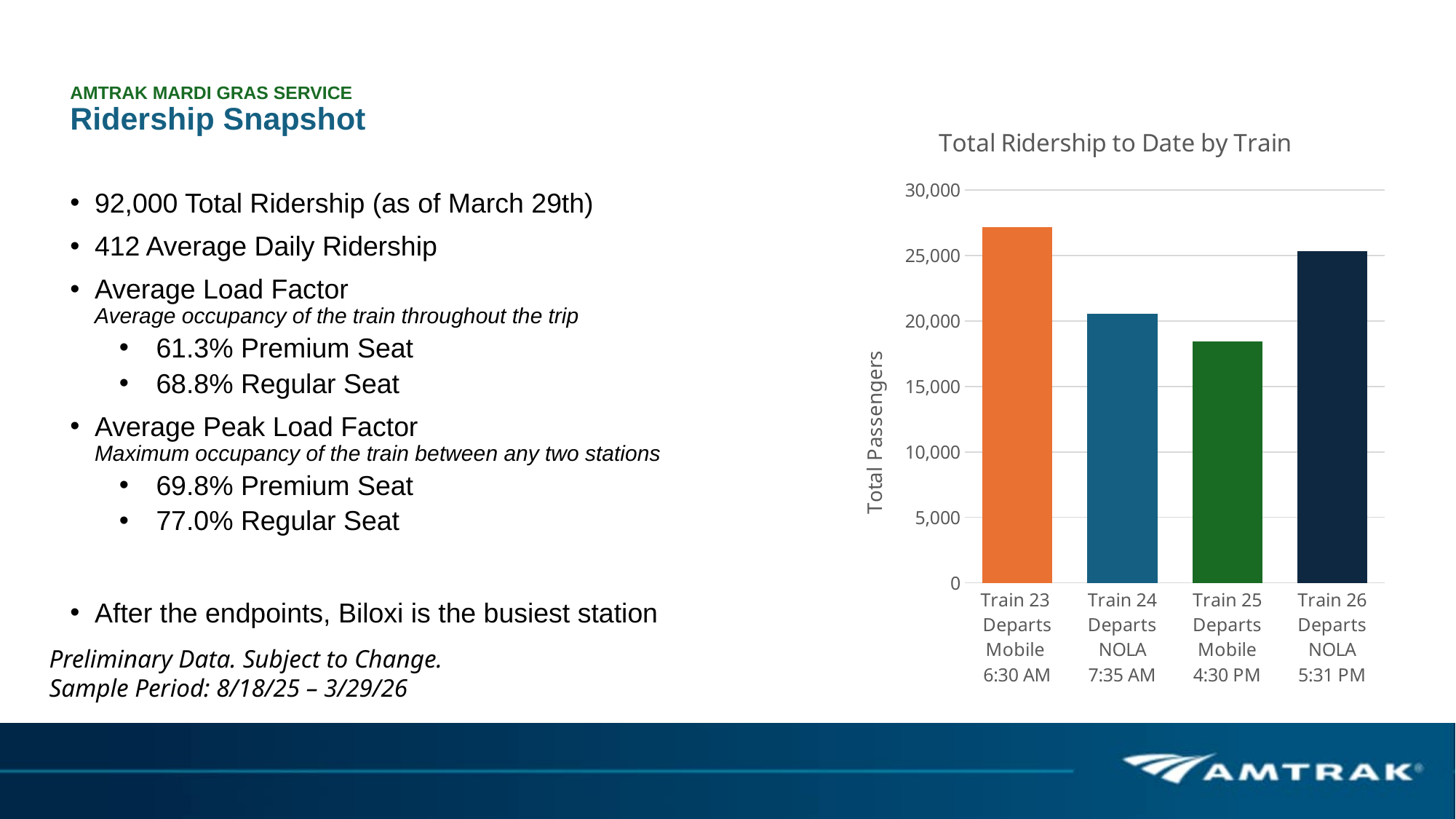
Is the total ridership for Train 23 greater or less than 25,000? greater Which train has the lowest total ridership to date? Train 25 What is the title of the chart? Total Ridership to Date by Train Which train has the highest total ridership to date? Train 23 Which has higher total ridership, Train 24 or Train 25? Train 24 Is the total ridership for Train 24 greater or less than 25,000? less Is the total ridership for Train 25 greater or less than 20,000? less What is the label on the vertical axis of the chart? Total Passengers Which has higher total ridership, Train 23 or Train 26? Train 23 What type of chart is shown on the slide? bar chart How many trains are shown in the chart? 4